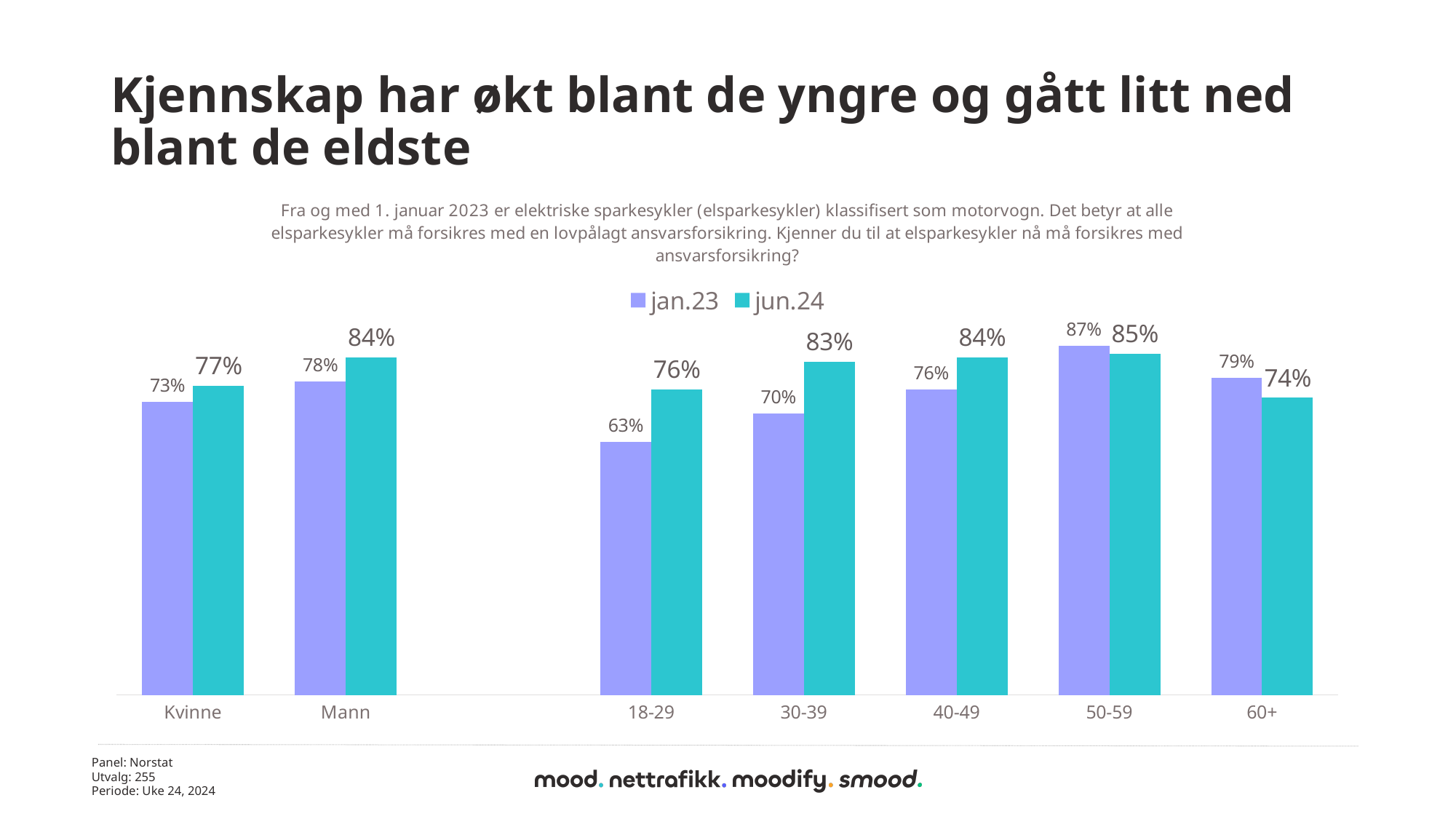
How many categories are shown on the x axis? 7 Which category has the lowest jan.23 value? 18-29 What is the jan.23 value for 18-29? 63% What is the difference between the jun.24 and jan.23 values for 18-29? 13 percentage points Which is larger for 60+, the jan.23 value or the jun.24 value? jan.23 What is the jun.24 value for Kvinne? 77% How many series does the legend list? 2 What kind of chart is shown on the slide? Bar chart What is the jun.24 value for 60+? 74% What is the jan.23 value for 50-59? 87% Which series is shown in teal in the legend? jun.24 Which category has the highest jan.23 value? 50-59